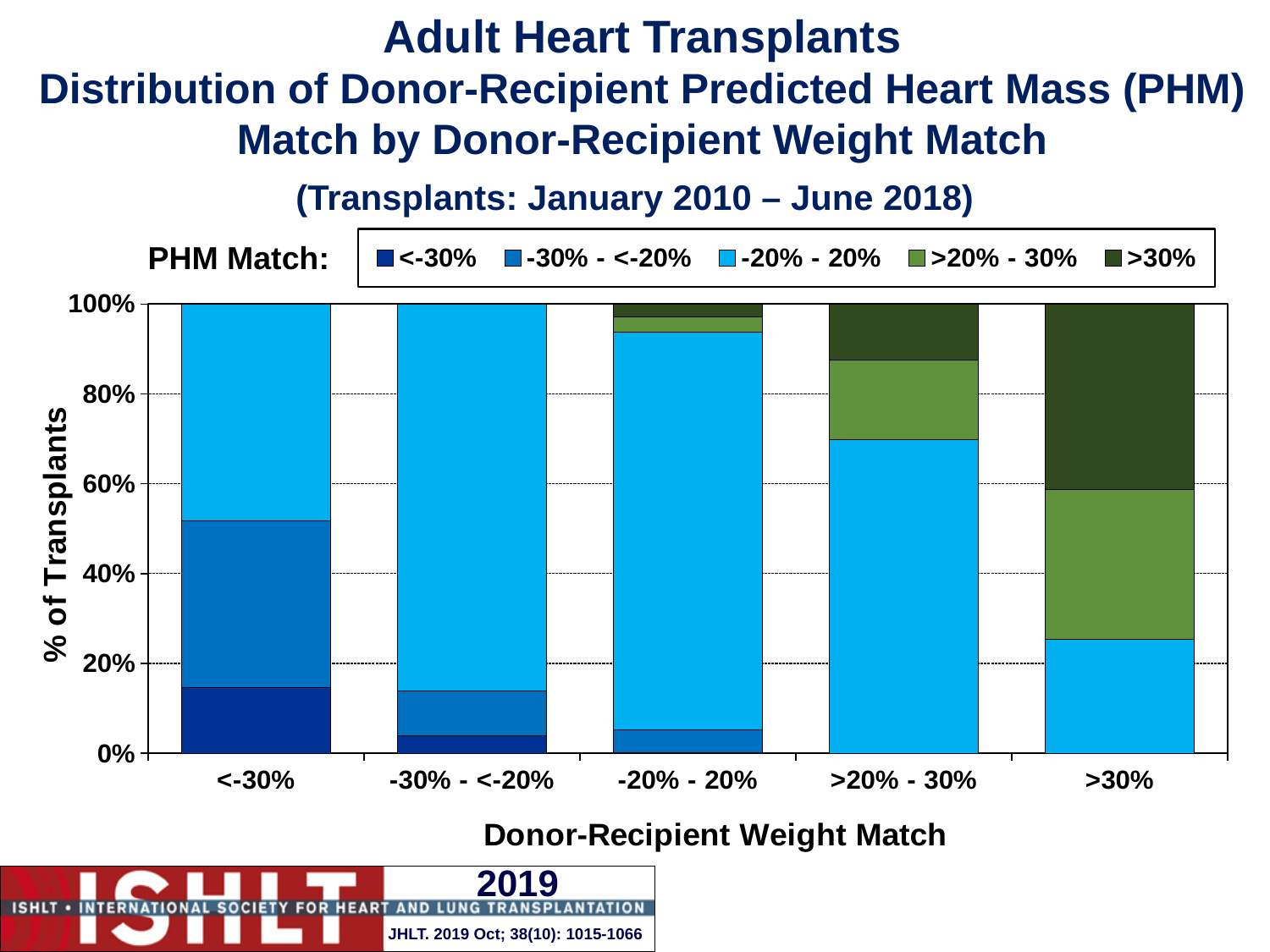
Which weight match category has the largest <-30% PHM match segment? <-30% Does the share of >30% PHM match rise or fall as the weight match category moves from <-30% to >30%? rises How many donor-recipient weight match categories are shown on the x axis? 5 What kind of chart is shown on the slide? Stacked bar chart In the >20% - 30% weight match bar, is the -20% - 20% PHM match segment greater or less than 60%? greater What is the total height of each stacked bar? 100% In the <-30% weight match bar, is the <-30% PHM match segment greater or less than 20%? less How many PHM Match series does the legend list? 5 In the >30% weight match bar, is the -20% - 20% PHM match segment greater or less than 40%? less What is the title of the x axis? Donor-Recipient Weight Match In the >30% weight match bar, which PHM match segment is larger: >30% or >20% - 30%? >30%